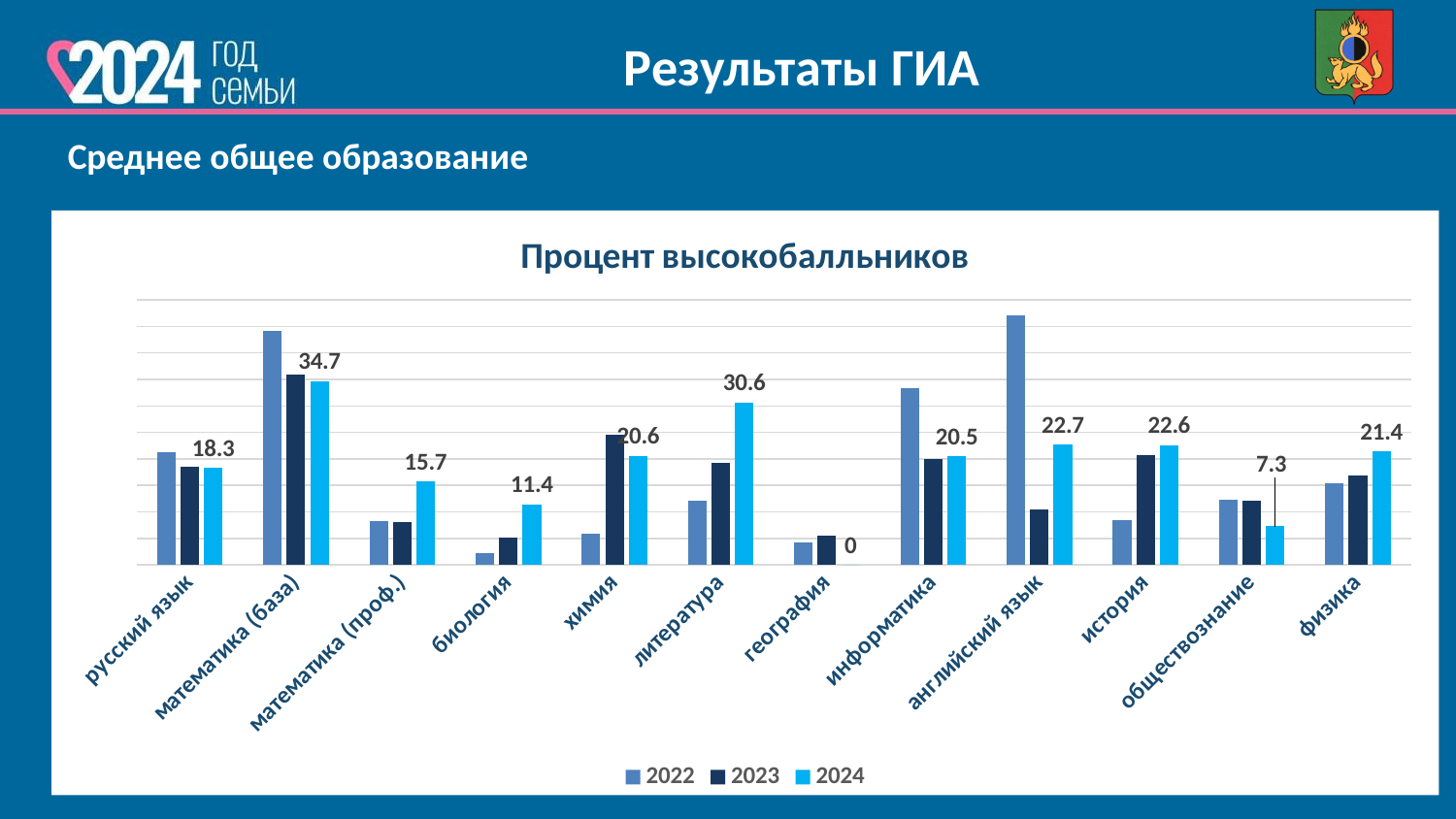
Which subject has the highest 2024 value? математика (база) What is the 2024 value for литература? 30.6 What is the difference between the 2024 values for математика (база) and литература? 4.1 What is the 2024 value for обществознание? 7.3 What is the 2024 value for математика (база) in the chart 'Процент высокобалльников'? 34.7 Which subject has the lowest 2024 value? география What kind of chart is shown on the slide? bar chart What is the title of the chart? Процент высокобалльников Which has the larger 2024 value: литература or химия? литература How many subjects are shown on the x axis of the chart? 12 How many series does the legend list? 3 What is the 2024 value for география? 0